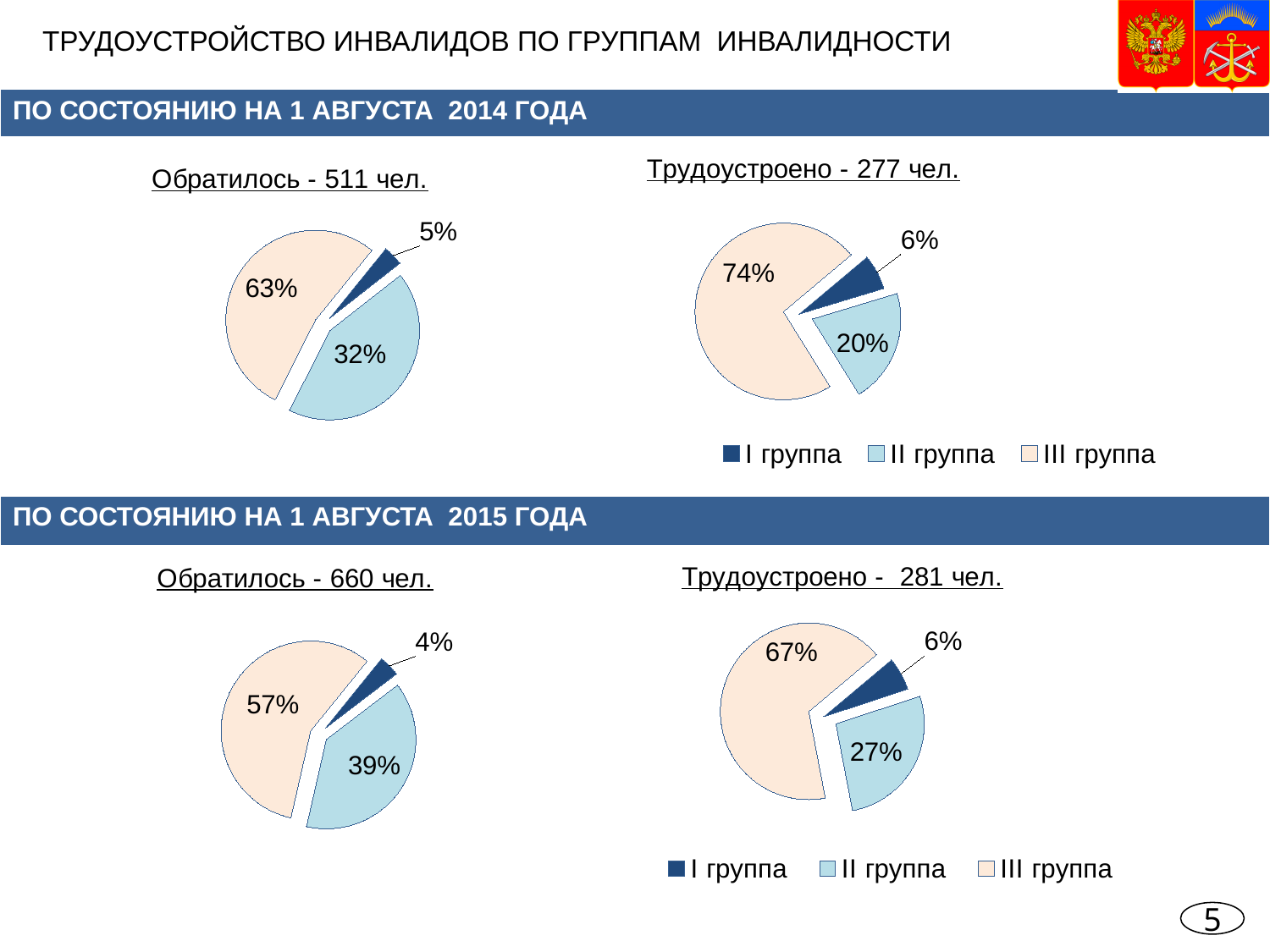
In the 2014 'Обратилось - 511 чел.' pie chart, which is larger: the share of II группа or the share of I группа? II группа In the 2014 'Обратилось - 511 чел.' pie chart, what share does III группа have? 63% What type of chart is used for 'Обратилось - 660 чел.' in the 2015 section? Pie chart In the 2014 'Трудоустроено - 277 чел.' pie chart, which group has the largest slice? III группа In the 2015 'Обратилось - 660 чел.' pie chart, what share does II группа have? 39% In the 2015 'Трудоустроено - 281 чел.' pie chart, what is the difference in percentage points between III группа and II группа? 40 In the 2014 'Трудоустроено - 277 чел.' pie chart, what share does I группа have? 6% How many slices does the 2015 'Трудоустроено - 281 чел.' pie chart have? 3 How many entries does the legend below the 2014 'Трудоустроено - 277 чел.' chart list? 3 In the 2015 'Обратилось - 660 чел.' pie chart, which group has the smallest slice? I группа